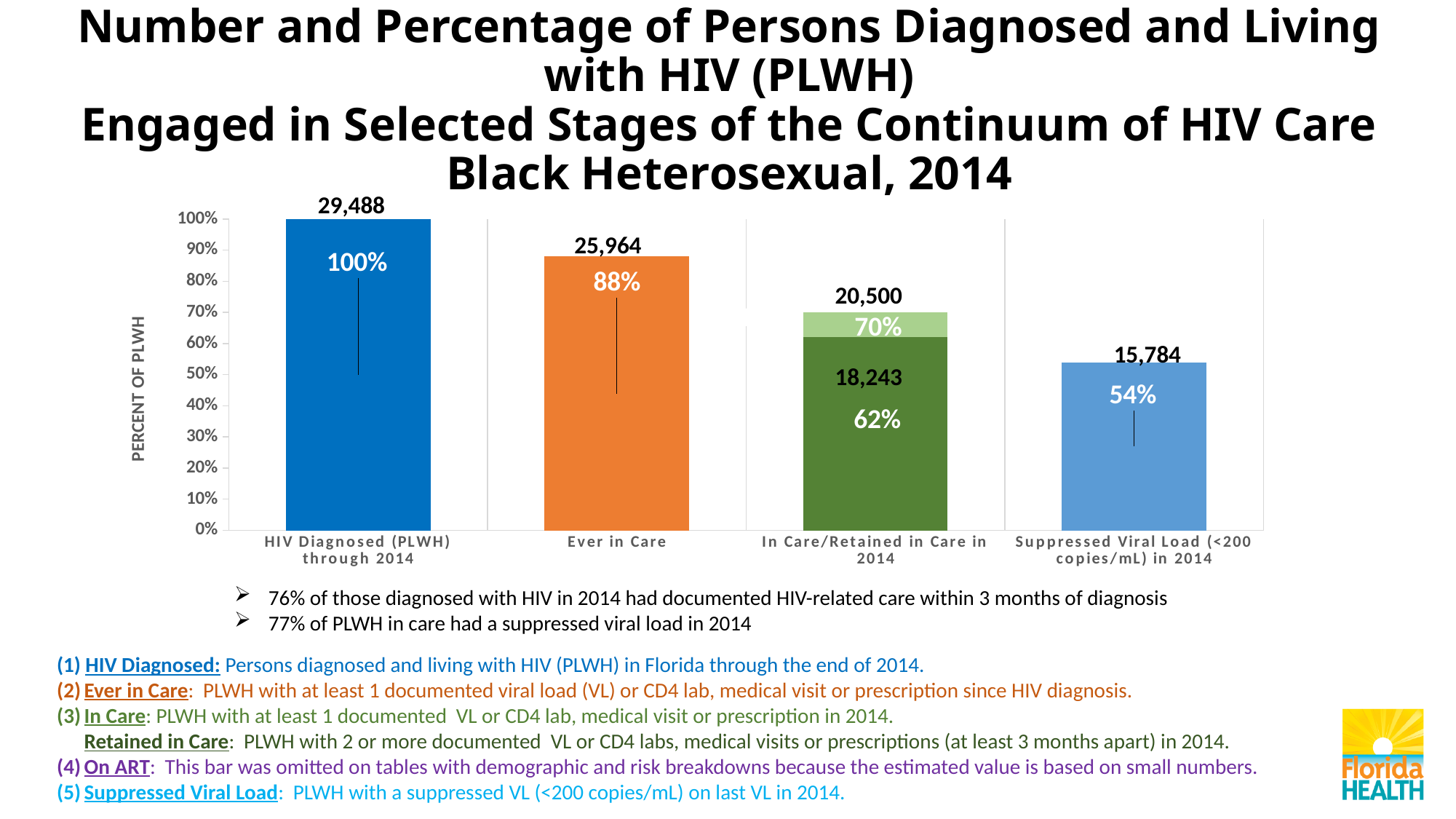
What percentage is shown for the Ever in Care bar? 88% Which stage has the lowest percentage of PLWH? Suppressed Viral Load (<200 copies/mL) in 2014 What is the difference in percentage points between Ever in Care and Suppressed Viral Load in 2014? 34 What number of persons is labeled on the Suppressed Viral Load (<200 copies/mL) in 2014 bar? 15,784 Do the percentages rise or fall moving from left to right across the stages? Fall Which is larger: the number Ever in Care or the number In Care in 2014? Ever in Care What percentage is shown for Retained in Care (the dark green portion of the In Care/Retained in Care bar)? 62% What type of chart is shown on the slide? Bar chart Which stage has the highest number of persons? HIV Diagnosed (PLWH) through 2014 How many stages (bars) are shown on the x axis? 4 What number is labeled for the In Care portion (top of the In Care/Retained in Care in 2014 bar)? 20,500 What number is labeled at the top of the HIV Diagnosed (PLWH) through 2014 bar? 29,488